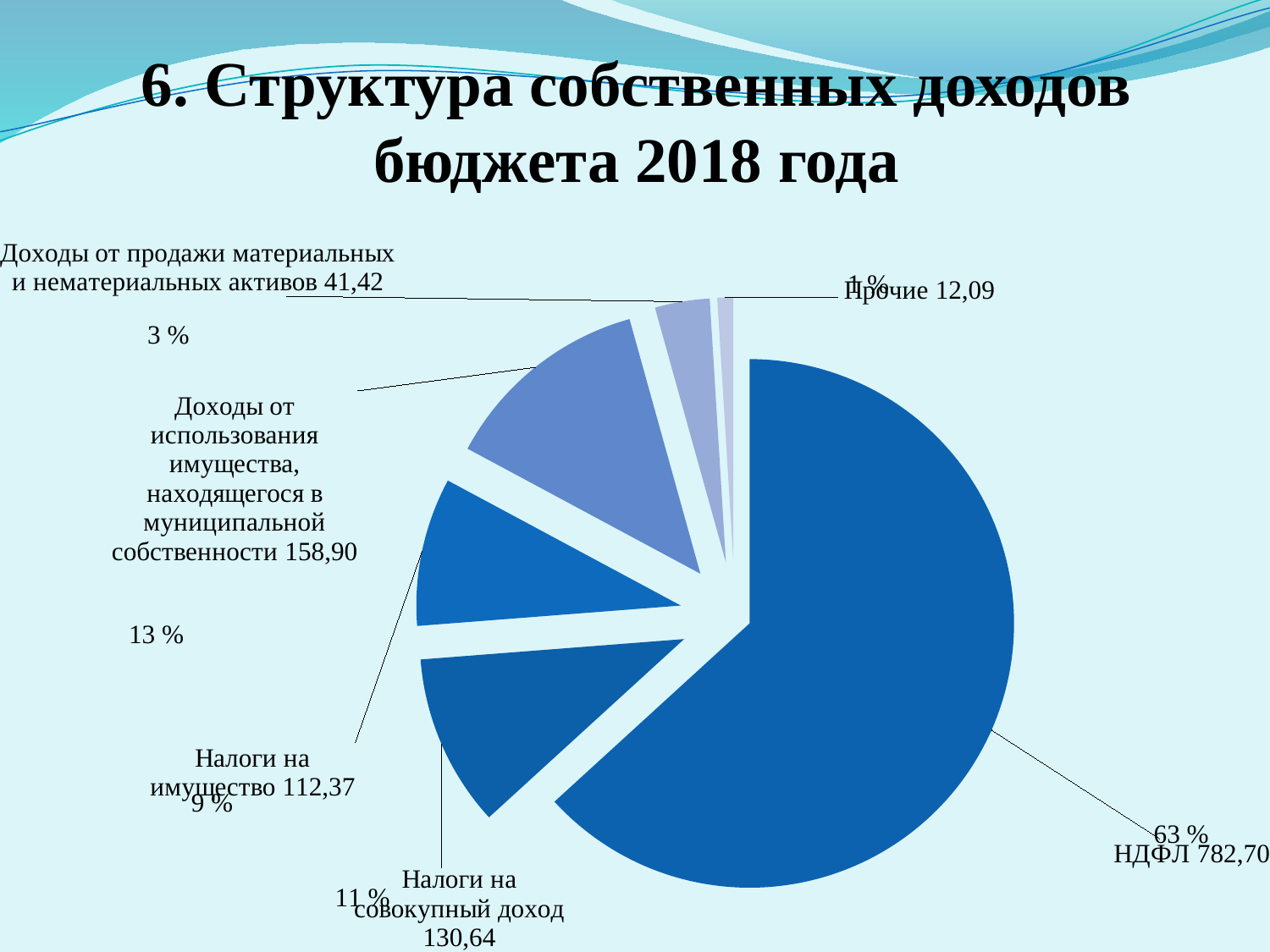
What is the value shown for Прочие? 12,09 What is the value shown for Налоги на совокупный доход? 130,64 Which category has the smallest slice of the pie? Прочие What share of the pie does НДФЛ represent? 63 % Which category has the largest slice of the pie? НДФЛ What is the value shown for Налоги на имущество? 112,37 What kind of chart is shown on the slide? pie chart What is the value shown for НДФЛ? 782,70 What is the difference between the values for Доходы от использования имущества, находящегося в муниципальной собственности (158,90) and Доходы от продажи материальных и нематериальных активов (41,42)? 117,48 Which is larger: Налоги на имущество or Налоги на совокупный доход? Налоги на совокупный доход How many slices does the pie chart have? 6 What share of the pie does Доходы от использования имущества, находящегося в муниципальной собственности represent? 13 %